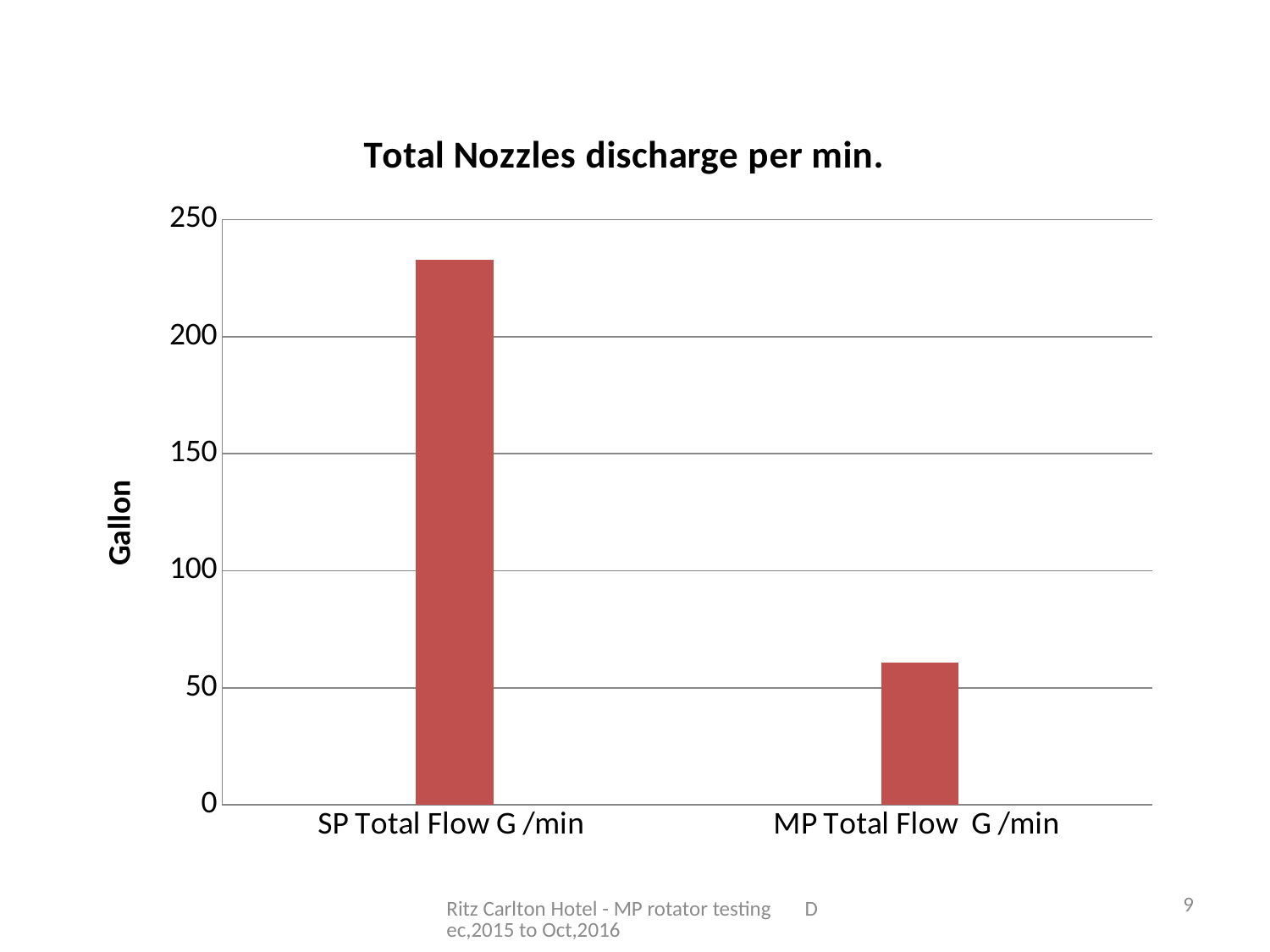
Do the values rise or fall from the left bar to the right bar? fall What is the label on the vertical axis of the chart? Gallon Is the value for MP Total Flow G /min greater or less than 100? less Is the value for SP Total Flow G /min greater or less than 200? greater Is the value for MP Total Flow G /min greater or less than 50? greater Which category has the lowest value in the chart? MP Total Flow G /min How many bars are plotted in the chart? 2 What type of chart is shown on the slide? bar chart Which category has the highest value in the chart? SP Total Flow G /min Which is larger, the value for SP Total Flow G /min or the value for MP Total Flow G /min? SP Total Flow G /min What is the title of the chart? Total Nozzles discharge per min.